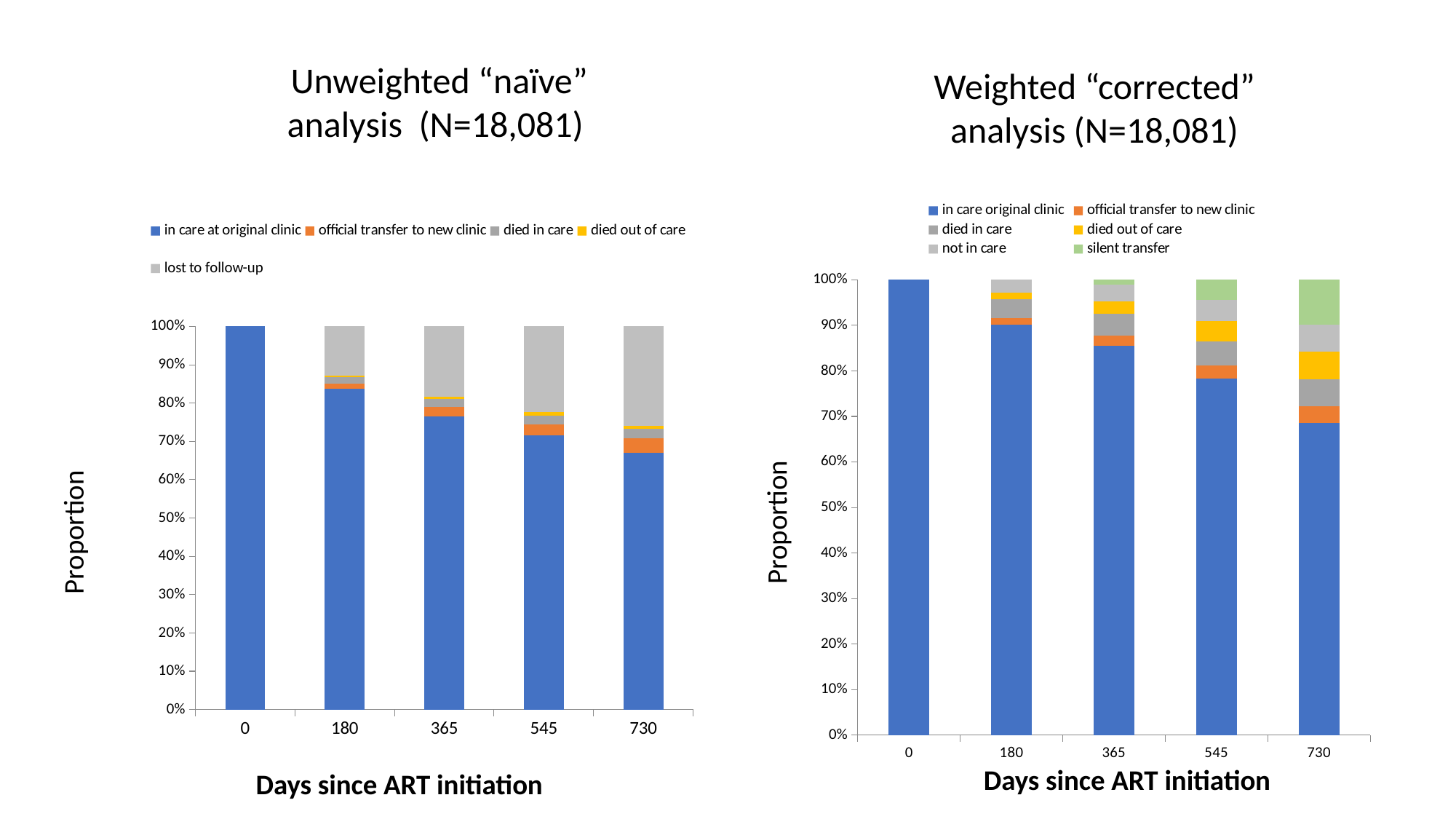
In the Weighted "corrected" analysis chart, what is the total height of the stacked bar at 730 days? 100% In the Weighted "corrected" analysis chart, is the proportion in care original clinic at 365 days greater or less than 80%? greater How many bars (time points) are shown on the x axis of the Weighted "corrected" analysis chart? 5 What kind of chart is the Unweighted "naïve" analysis chart on the left? Stacked bar chart In the Unweighted "naïve" analysis chart, what proportion is in care at original clinic at 0 days since ART initiation? 100% In the Unweighted "naïve" analysis chart, is the proportion in care at original clinic at 730 days greater or less than 70%? less In the Weighted "corrected" analysis chart, does the proportion in care original clinic rise or fall as days since ART initiation increase? Fall How many series does the legend of the Unweighted "naïve" analysis chart list? 5 Which series appears in the legend of the Weighted "corrected" analysis chart but not in the Unweighted "naïve" analysis chart's legend? not in care and silent transfer In the Unweighted "naïve" analysis chart, is the proportion in care at original clinic at 180 days greater or less than 80%? greater How many series does the legend of the Weighted "corrected" analysis chart list? 6